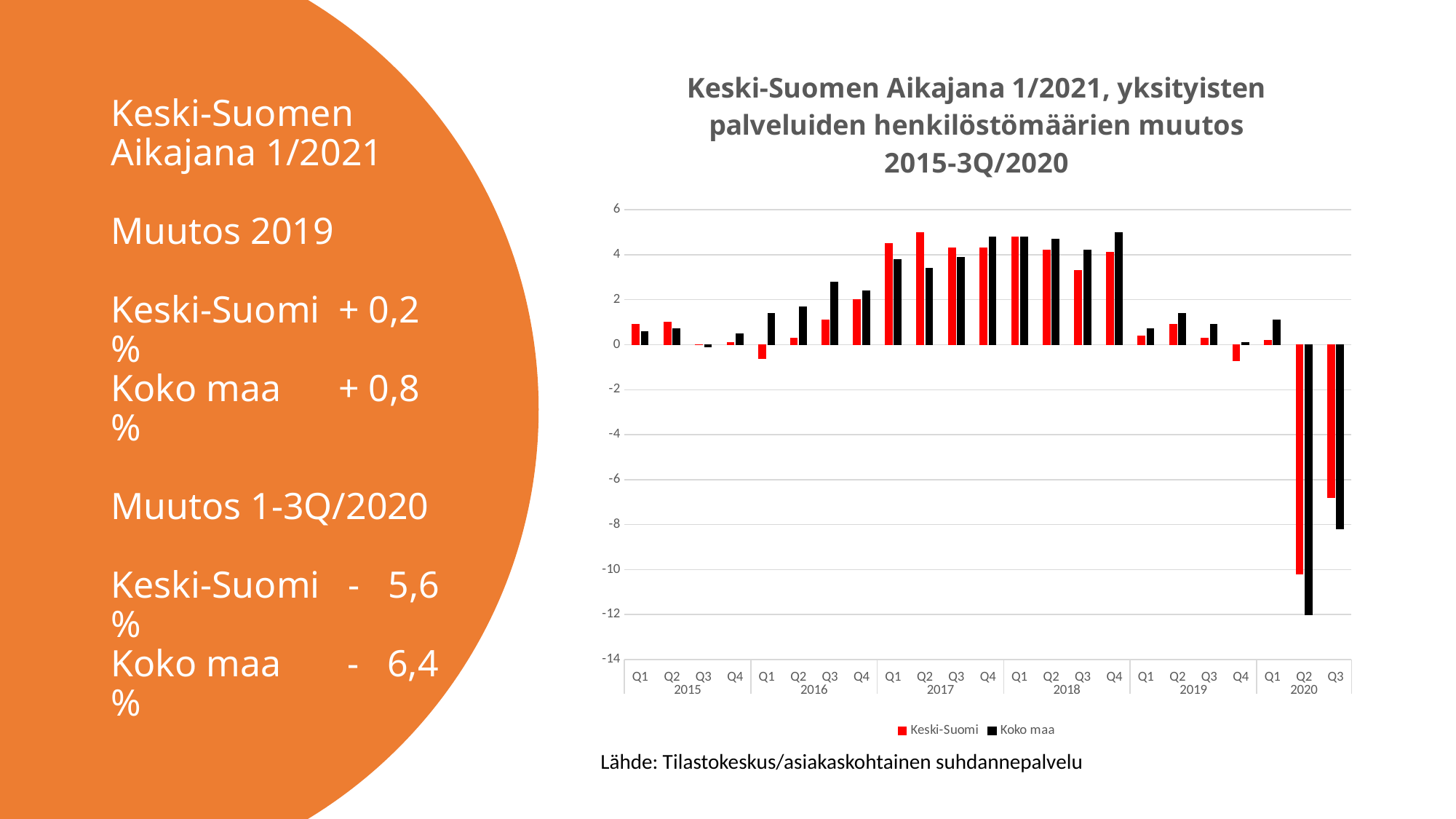
How many quarters are plotted along the x axis of the chart? 23 Is the Koko maa value for Q2 2020 greater or less than -10? less In Q2 2020, which series has the lower value, Keski-Suomi or Koko maa? Koko maa What are the two series named in the chart legend? Keski-Suomi and Koko maa What kind of chart is shown on the slide? bar chart How many series does the chart legend list? 2 Is the Keski-Suomi value for Q2 2020 greater or less than -8? less In which quarter is the Koko maa value lowest? Q2 2020 In Q1 2016, which series has the larger value, Keski-Suomi or Koko maa? Koko maa Is the Keski-Suomi value for Q2 2017 greater or less than 4? greater In which quarter is the Keski-Suomi value lowest? Q2 2020 Do the Koko maa values generally rise or fall from Q1 2019 to Q3 2020? fall